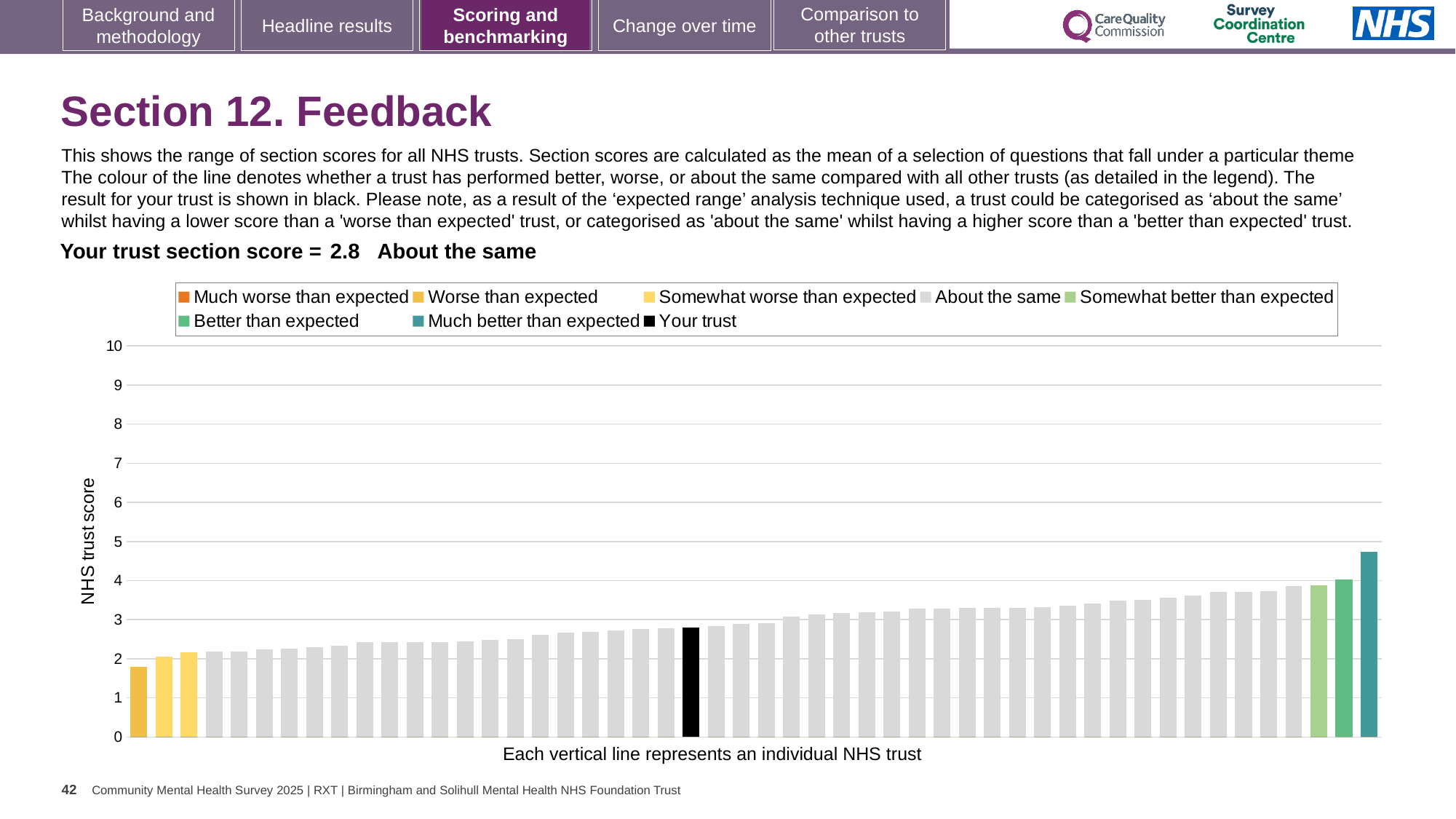
How many entries does the chart legend list? 8 Do the bar values rise or fall from left to right along the x axis? rise Is the value of the shortest bar greater or less than 2? less Is the value of the tallest bar greater or less than 4? greater What colour is the bar representing your trust? black How is the trust's section score categorised compared with other trusts? About the same What kind of chart is shown on the slide? bar chart Is the trust's section score of 2.8 greater or less than 3? less What is the label on the vertical axis? NHS trust score What is the trust's section score for Section 12 Feedback? 2.8 Which legend category does the tallest bar belong to? Much better than expected What is the highest value shown on the vertical axis? 10